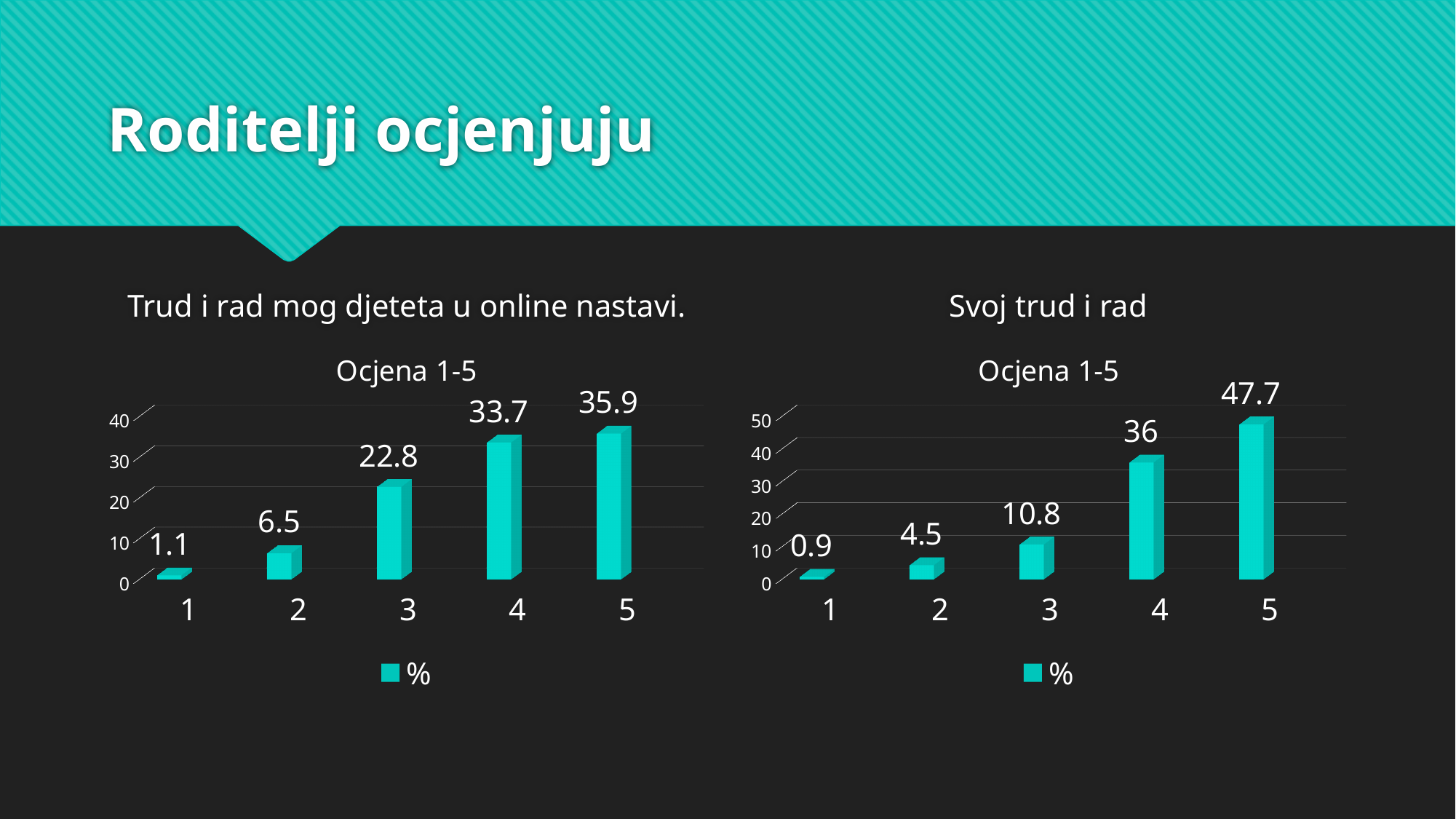
In the left chart (Trud i rad mog djeteta u online nastavi), what is the value for category 3? 22.8 How many categories are shown on the x axis of the left chart (Trud i rad mog djeteta u online nastavi)? 5 How many series does the legend of the right chart (Svoj trud i rad) list? 1 In the left chart (Trud i rad mog djeteta u online nastavi), which category has the highest value? 5 In the right chart (Svoj trud i rad), do the values rise or fall from category 1 to category 5? rise In the left chart (Trud i rad mog djeteta u online nastavi), which is larger: the value for category 2 or category 3? 3 In the right chart (Svoj trud i rad), what is the difference between the values for category 5 and category 4? 11.7 In the right chart (Svoj trud i rad), is the value for category 5 greater or less than 40? greater In the right chart (Svoj trud i rad), what is the value for category 4? 36 In the right chart (Svoj trud i rad), which category has the lowest value? 1 What kind of chart is the right chart (Svoj trud i rad)? bar chart In the left chart (Trud i rad mog djeteta u online nastavi), what is the difference between the values for category 4 and category 3? 10.9